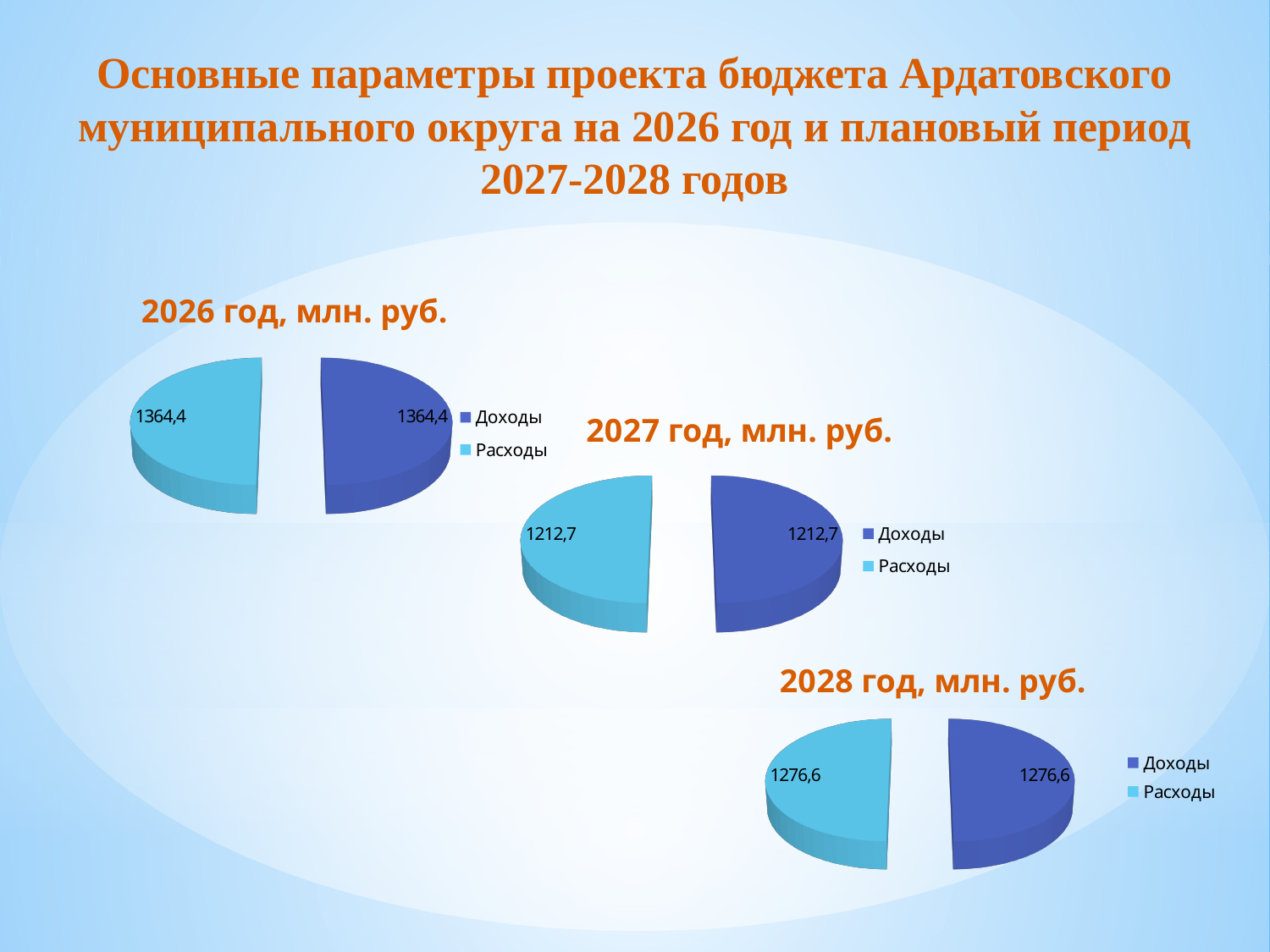
In the chart titled "2027 год, млн. руб.", what is the value for Расходы? 1212,7 In the chart titled "2026 год, млн. руб.", what is the difference between Доходы and Расходы? 0 How many entries does the legend of the chart titled "2028 год, млн. руб." list? 2 In the chart titled "2028 год, млн. руб.", what is the value for Расходы? 1276,6 In the chart titled "2028 год, млн. руб.", what is the value for Доходы? 1276,6 In the chart titled "2026 год, млн. руб.", what is the value for Расходы? 1364,4 In the chart titled "2027 год, млн. руб.", what is the value for Доходы? 1212,7 How many pie charts are shown on the slide? 3 In the chart titled "2026 год, млн. руб.", what is the value for Доходы? 1364,4 How many slices does the chart titled "2027 год, млн. руб." have? 2 What kind of chart is the chart titled "2026 год, млн. руб."? Pie chart In the chart titled "2027 год, млн. руб.", what share of the pie does Доходы represent? 50%